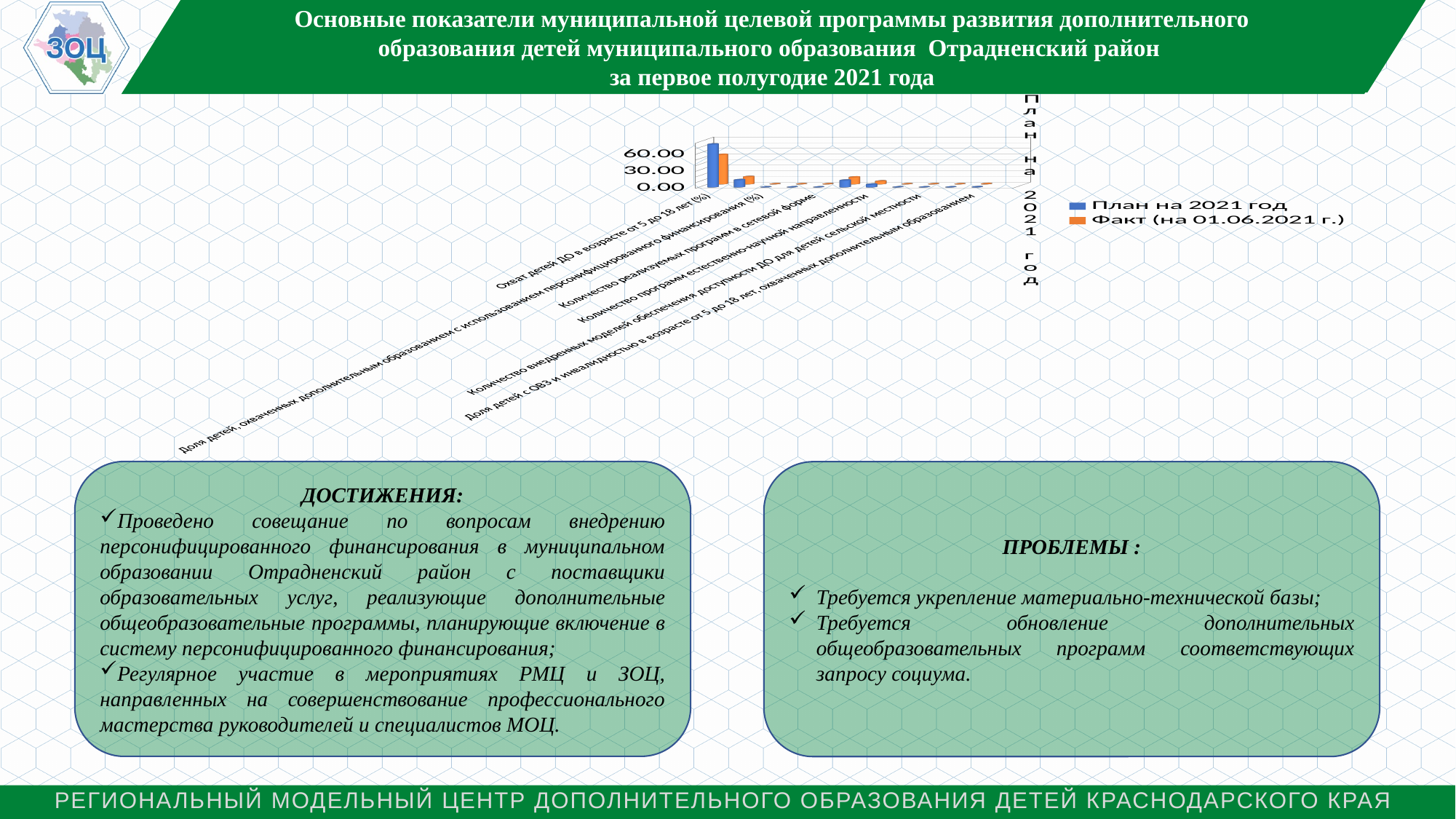
Which category has the highest value for the series 'План на 2021 год'? Охват детей ДО в возрасте от 5 до 18 лет (%) What are the two series named in the chart legend? План на 2021 год; Факт (на 01.06.2021 г.) Which colour represents the series 'Факт (на 01.06.2021 г.)' in the chart? orange Is the 'План на 2021 год' value for 'Количество реализуемых программ в сетевой форме' greater or less than 30.00? less What kind of chart is shown on the slide? bar chart How many series does the chart legend list? 2 What is the highest tick value shown on the chart's vertical axis? 60.00 Which is larger for the series 'План на 2021 год': the value for 'Охват детей ДО в возрасте от 5 до 18 лет (%)' or the value for 'Доля детей, охваченных дополнительным образованием с использованием персонифицированного финансирования (%)'? Охват детей ДО в возрасте от 5 до 18 лет (%) Is the 'Факт (на 01.06.2021 г.)' value for 'Охват детей ДО в возрасте от 5 до 18 лет (%)' greater or less than 30.00? greater Is the 'План на 2021 год' value for 'Охват детей ДО в возрасте от 5 до 18 лет (%)' greater or less than 30.00? greater